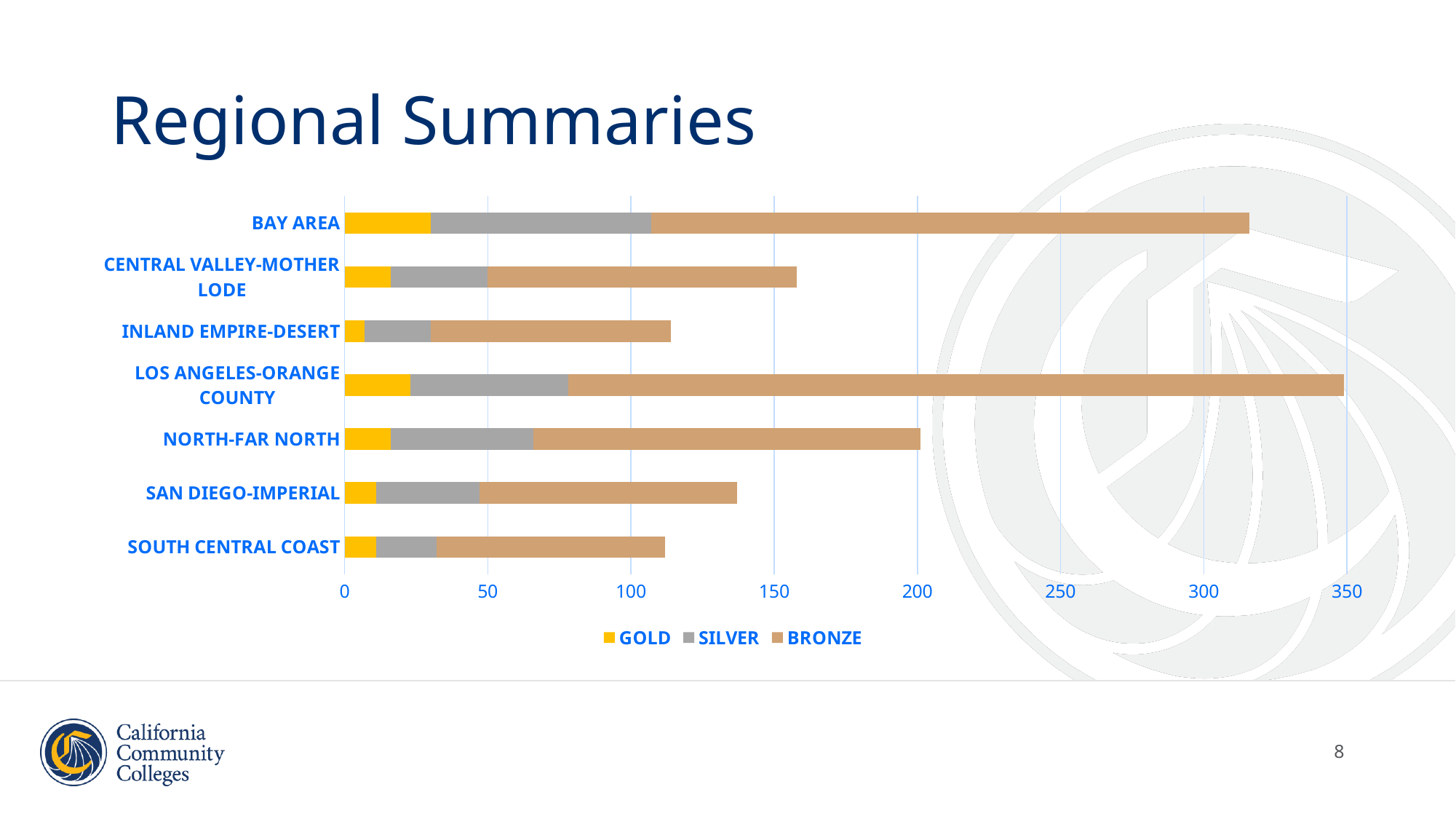
Is the total bar for Bay Area greater or less than 300? greater Which region has the longest Gold segment? Bay Area Is the total bar for Inland Empire-Desert greater or less than 150? less Which series is shown in the tan/brown colour in the legend? Bronze What are the three series named in the legend? Gold, Silver, Bronze Which region has the longest total bar? Los Angeles-Orange County What kind of chart is shown on the slide? Stacked bar chart How many series does the legend list? 3 Is the total bar for San Diego-Imperial greater or less than 150? less How many regions are listed on the chart? 7 Which has the longer total bar, Bay Area or North-Far North? Bay Area